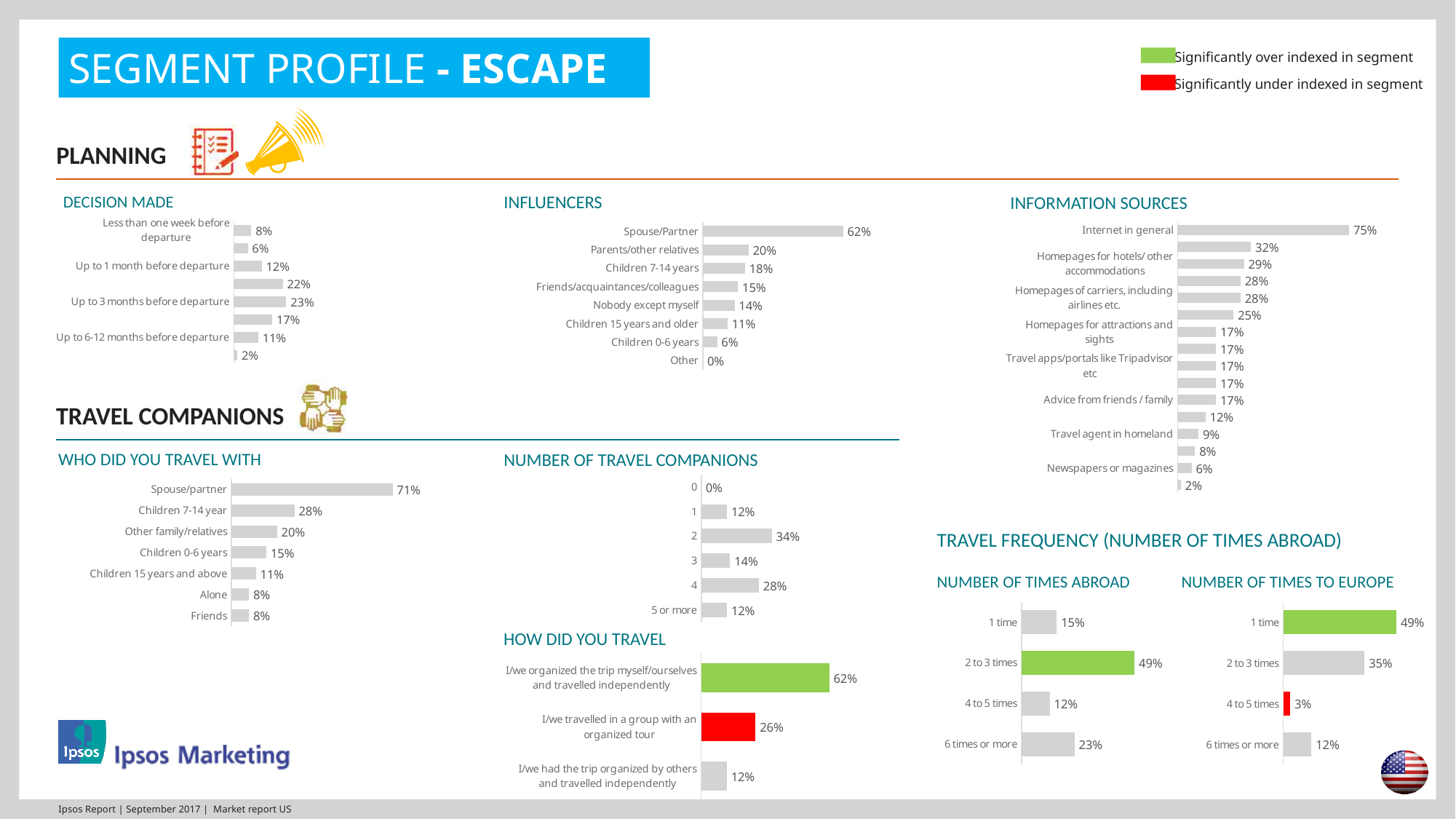
In the HOW DID YOU TRAVEL chart, what colour is the bar for 'I/we travelled in a group with an organized tour'? Red In the NUMBER OF TRAVEL COMPANIONS chart, which category has the highest value? 2 What kind of chart is the DECISION MADE chart? Bar chart In the INFORMATION SOURCES chart, what is the value for Internet in general? 75% In the WHO DID YOU TRAVEL WITH chart, which category has the highest value? Spouse/partner In the INFLUENCERS chart, what is the value for Spouse/Partner? 62% In the NUMBER OF TIMES ABROAD chart, which is larger: 1 time or 6 times or more? 6 times or more In the INFLUENCERS chart, which category has the lowest value? Other In the WHO DID YOU TRAVEL WITH chart, what is the difference between Spouse/partner and Children 7-14 year? 43% In the NUMBER OF TRAVEL COMPANIONS chart, how many categories are shown? 6 In the HOW DID YOU TRAVEL chart, what is the value for 'I/we travelled in a group with an organized tour'? 26% In the NUMBER OF TIMES TO EUROPE chart, what is the value for 4 to 5 times? 3%